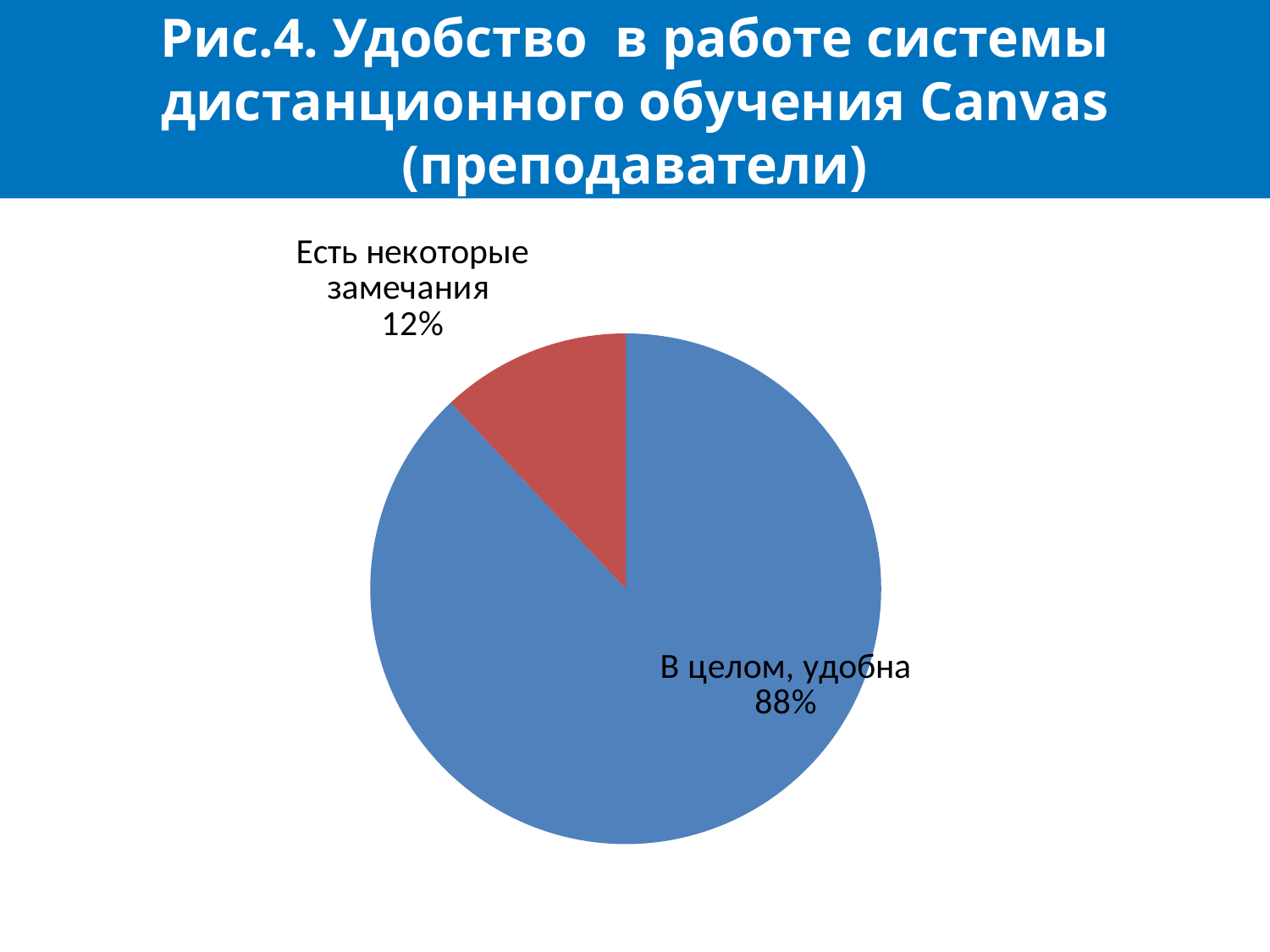
What is the total of the two slices shown in the pie chart? 100% What kind of chart is shown on the slide? Pie chart What is the title of the chart on the slide? Рис.4. Удобство в работе системы дистанционного обучения Canvas (преподаватели) What colour is the slice for "Есть некоторые замечания"? Red What share of the pie does "Есть некоторые замечания" represent? 12% What is the difference in percentage points between "В целом, удобна" and "Есть некоторые замечания"? 76 What share of the pie does "В целом, удобна" represent? 88% Which category has the smallest slice of the pie? Есть некоторые замечания Which category has the largest slice of the pie? В целом, удобна Which is larger: the share for "В целом, удобна" or for "Есть некоторые замечания"? В целом, удобна How many slices does the pie chart have? 2